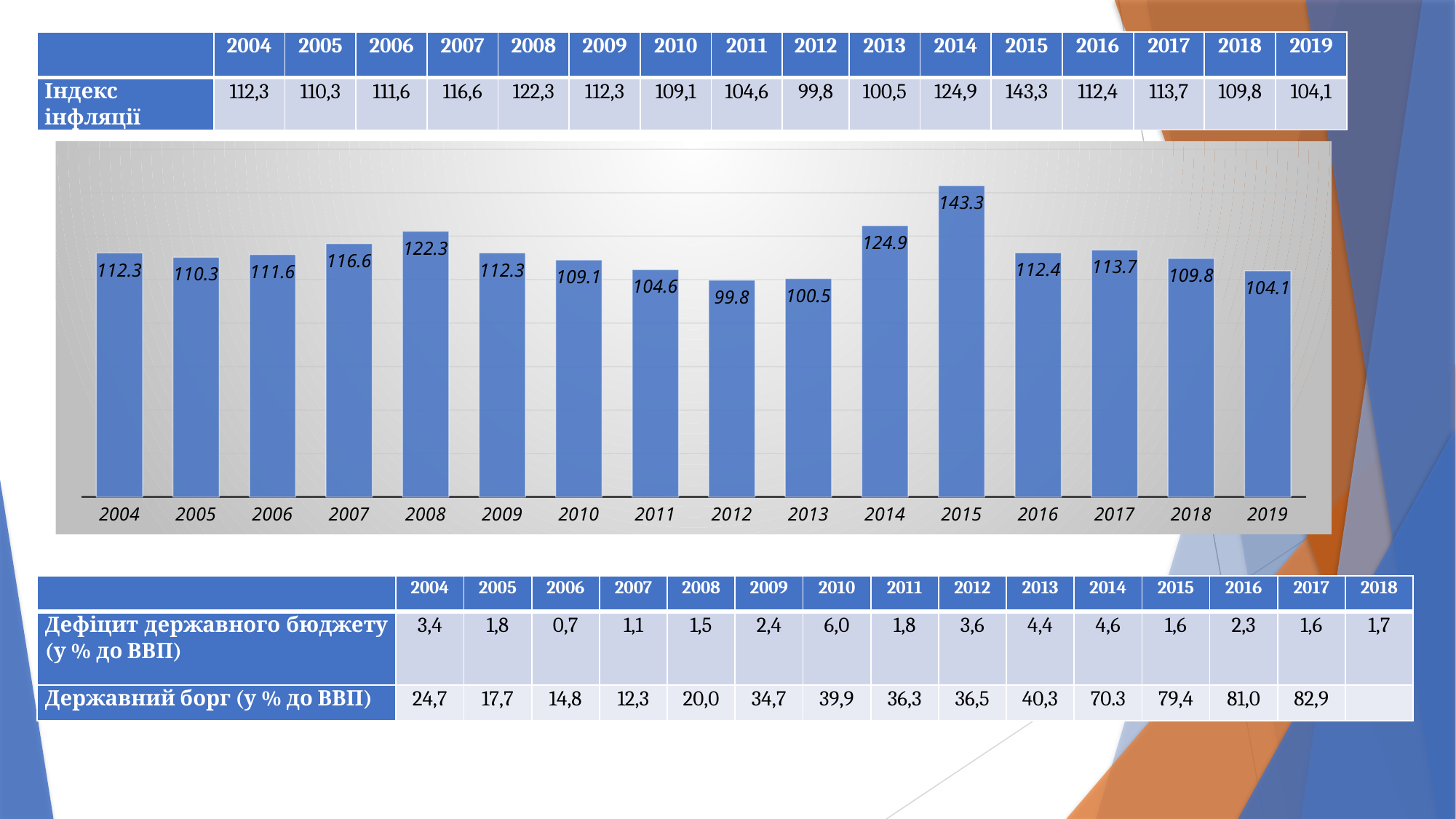
What is the value shown for 2015 in the bar chart? 143.3 Which year has the highest bar in the chart? 2015 What is the difference between the values for 2015 and 2014 in the bar chart? 18.4 Which is larger in the bar chart, the value for 2014 or the value for 2016? 2014 What is the value shown for 2008 in the bar chart? 122.3 Do the values in the bar chart rise or fall from 2015 to 2019? Fall What type of chart is shown on the slide? Bar chart How many bars are shown in the chart? 16 Which year has the lowest bar in the chart? 2012 What is the difference between the values for 2008 and 2009 in the bar chart? 10.0 Which is larger in the bar chart, the value for 2007 or the value for 2017? 2007 What is the value shown for 2012 in the bar chart? 99.8